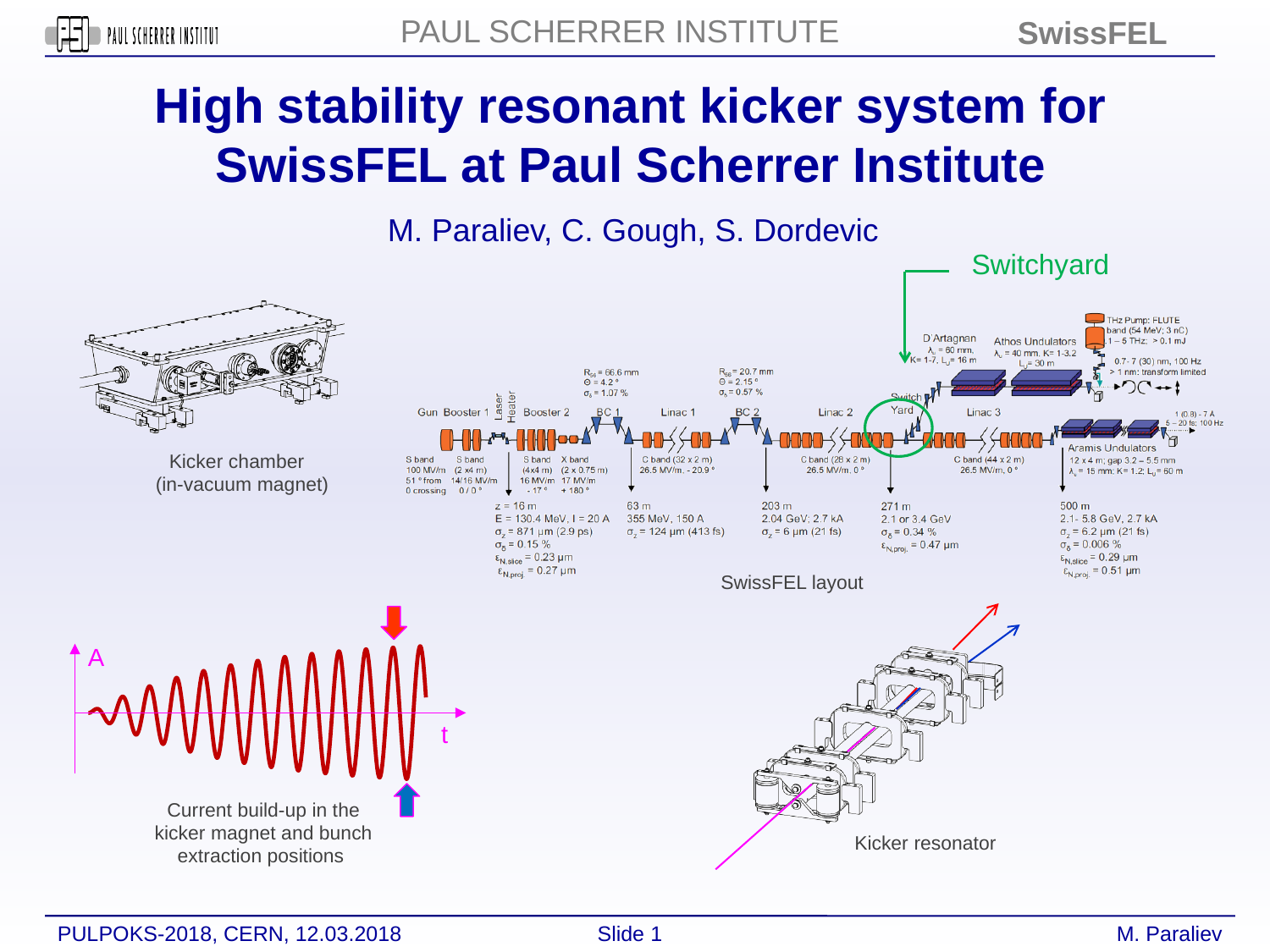
In the plot labelled 'Current build-up in the kicker magnet and bunch extraction positions', does the amplitude of the oscillation rise or fall along the t axis? rise In the plot at the bottom left of the slide, what is the label on the vertical axis? A In the plot at the bottom left of the slide, what is the label on the horizontal axis? t